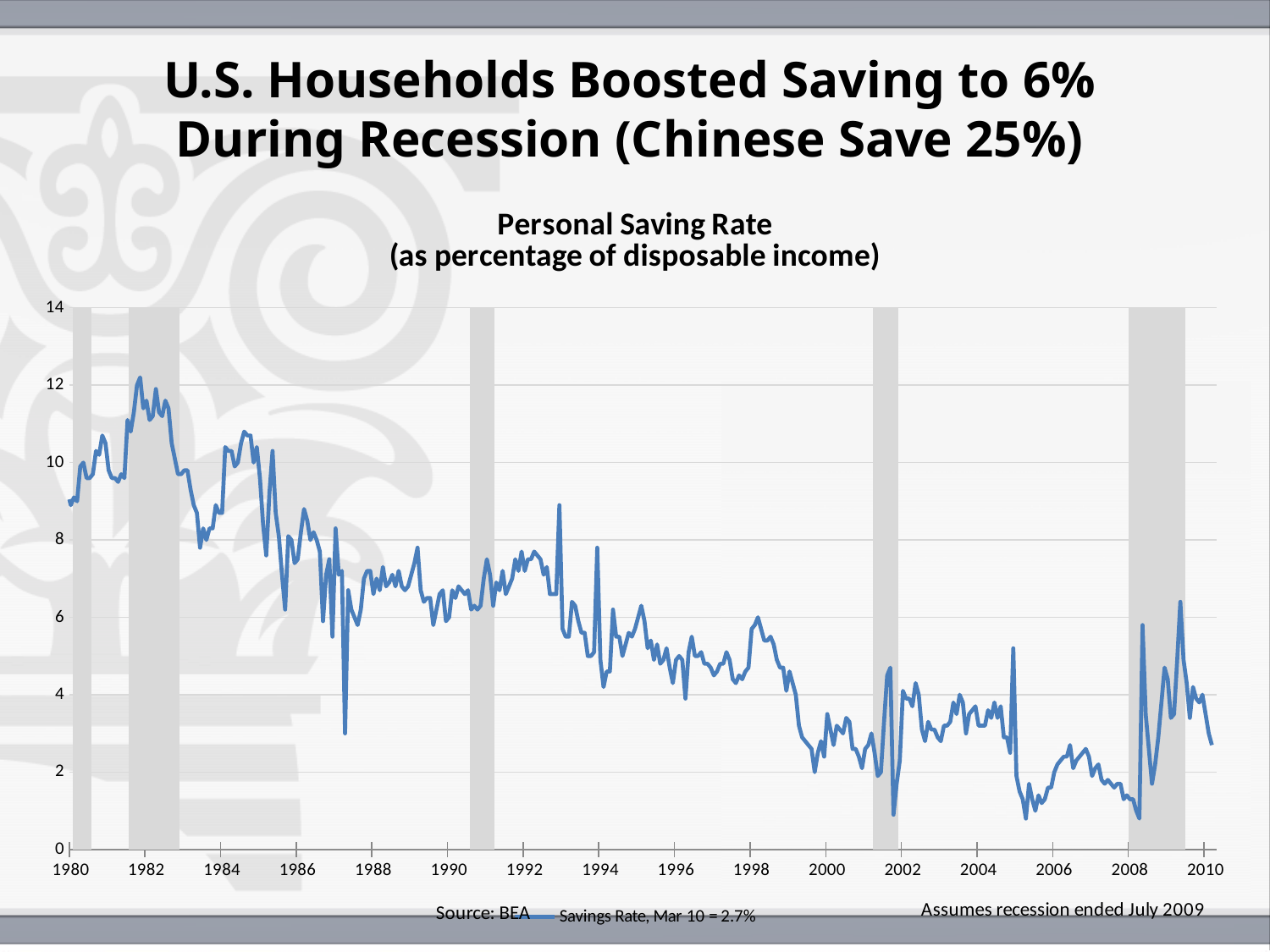
Is the personal saving rate in 1980 higher or lower than in 2010? higher Is the personal saving rate at the start of 1980 greater or less than 8? greater Is the peak personal saving rate around 1981-1982 greater or less than 10? greater Is the personal saving rate around 2000 greater or less than 4? less What is the title of the chart? Personal Saving Rate (as percentage of disposable income) In which period does the personal saving rate reach its highest value on the chart? around 1981-1982 How many series does the legend list? 1 What kind of chart is shown on the slide? line chart What is the source of the data shown in the chart? BEA Overall, does the personal saving rate rise or fall from 1980 to 2010? fall According to the legend, what was the savings rate in March 2010? 2.7%